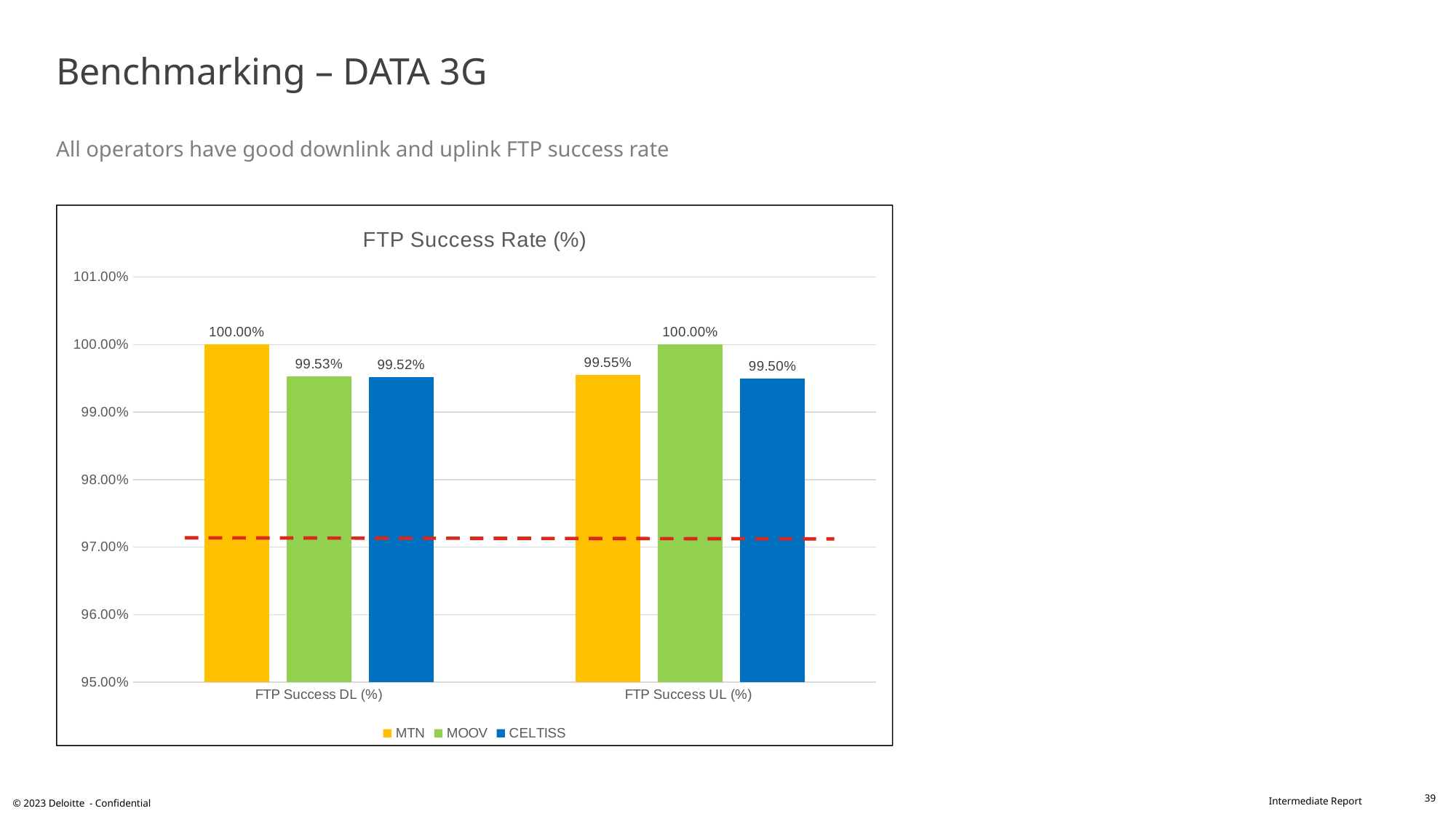
What is the difference between MTN's and CELTISS's FTP Success DL (%) values? 0.48% What kind of chart is shown on the slide? Bar chart Which operator has the highest FTP Success DL (%)? MTN Which operator has the highest FTP Success UL (%)? MOOV What is the FTP Success DL (%) value for MOOV? 99.53% Which is larger: MTN's FTP Success UL (%) or MOOV's FTP Success UL (%)? MOOV's FTP Success UL (%) How many series does the legend list? 3 What is the title of the chart? FTP Success Rate (%) What is the FTP Success UL (%) value for MTN? 99.55% Is the value for CELTISS in FTP Success DL (%) greater or less than 99.00%? greater What is the FTP Success UL (%) value for CELTISS? 99.50% What is the FTP Success DL (%) value for MTN? 100.00%